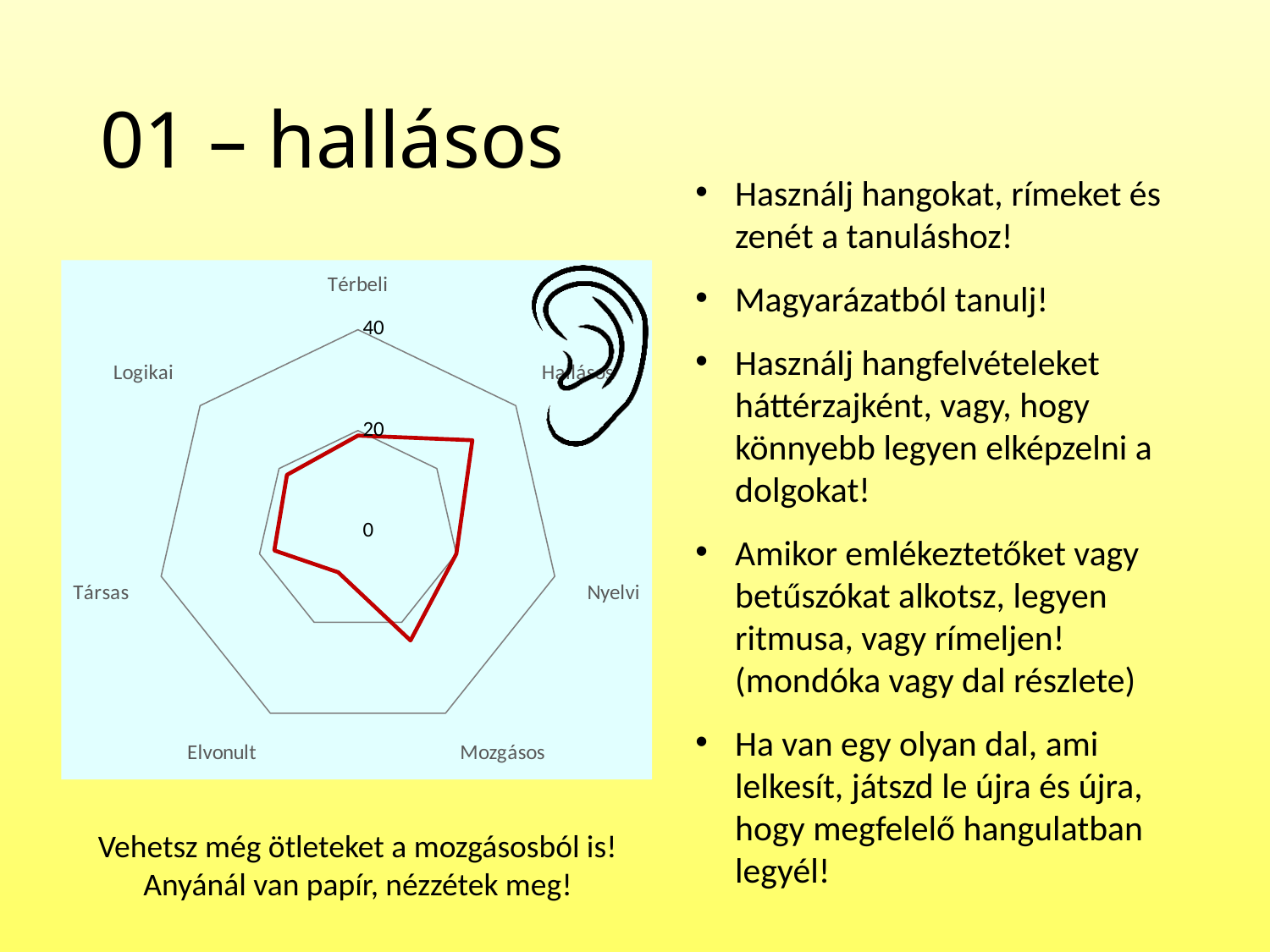
Is the value for Hallásos greater or less than 40? less What colour is the data line on the radar chart? red Which category has the highest value on the radar chart? Hallásos Is the value for Elvonult greater or less than 20? less Which is larger, the value for Hallásos or the value for Elvonult? Hallásos What kind of chart is shown on the slide? radar chart Which category has the lowest value on the radar chart? Elvonult Is the value for Hallásos greater or less than 20? greater Which is larger, the value for Mozgásos or the value for Elvonult? Mozgásos What is the highest tick value shown on the radar chart's axis? 40 How many categories (axes) does the radar chart have? 7